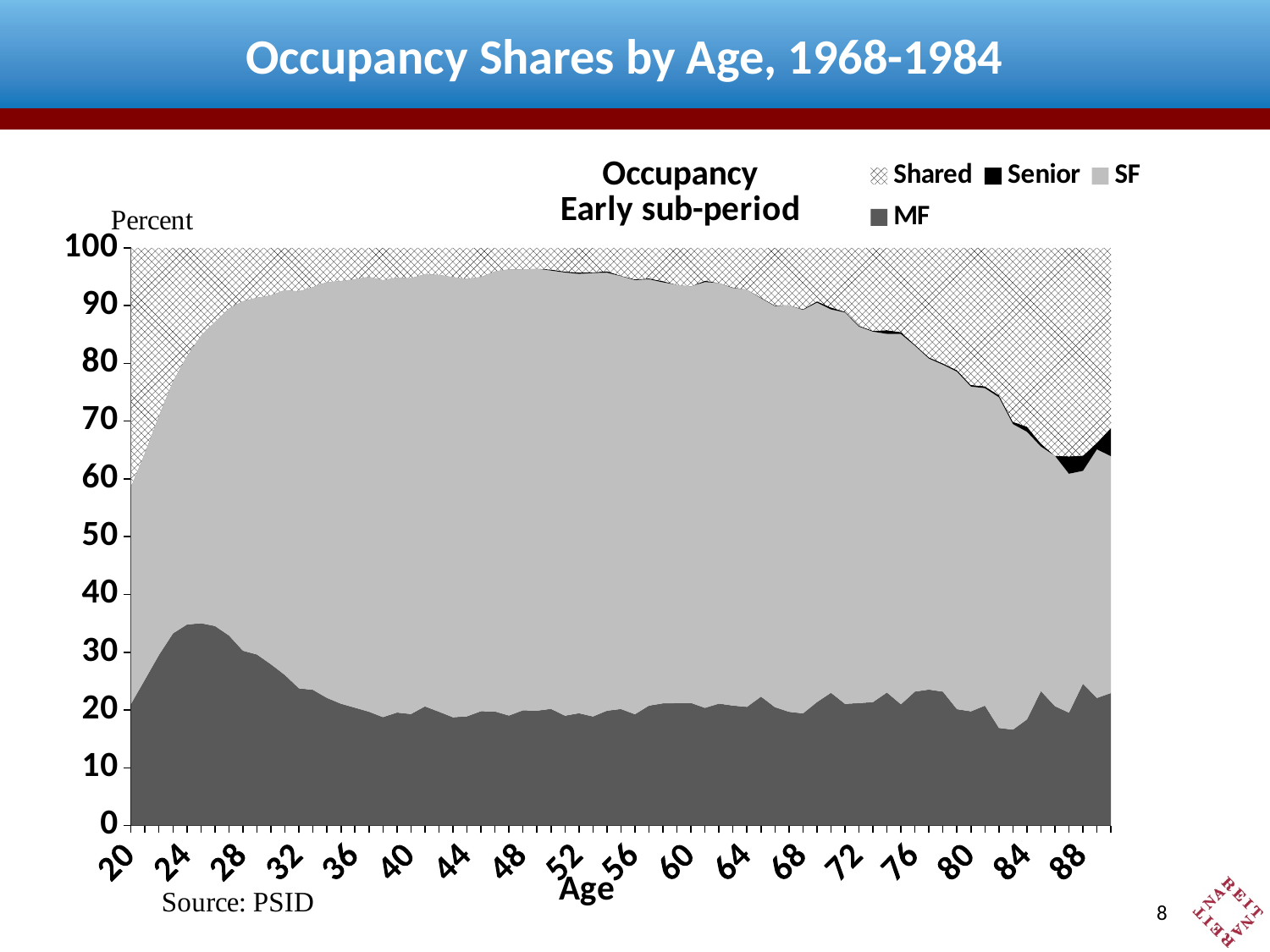
Which is larger, the MF share at age 26 or the MF share at age 44? Age 26 Is the MF share at age 26 greater or less than 30? greater How many series does the legend list? 4 What kind of chart is shown on the slide? Stacked area chart Is the combined MF and SF share at age 48 greater or less than 90? greater Is the MF share at age 60 greater or less than 30? less Which series appears only at the oldest ages (around 86 and above)? Senior Does the MF share rise or fall between age 26 and age 40? fall Does the Shared share rise or fall between age 60 and age 88? rise What are the series listed in the legend? Shared, Senior, SF, MF